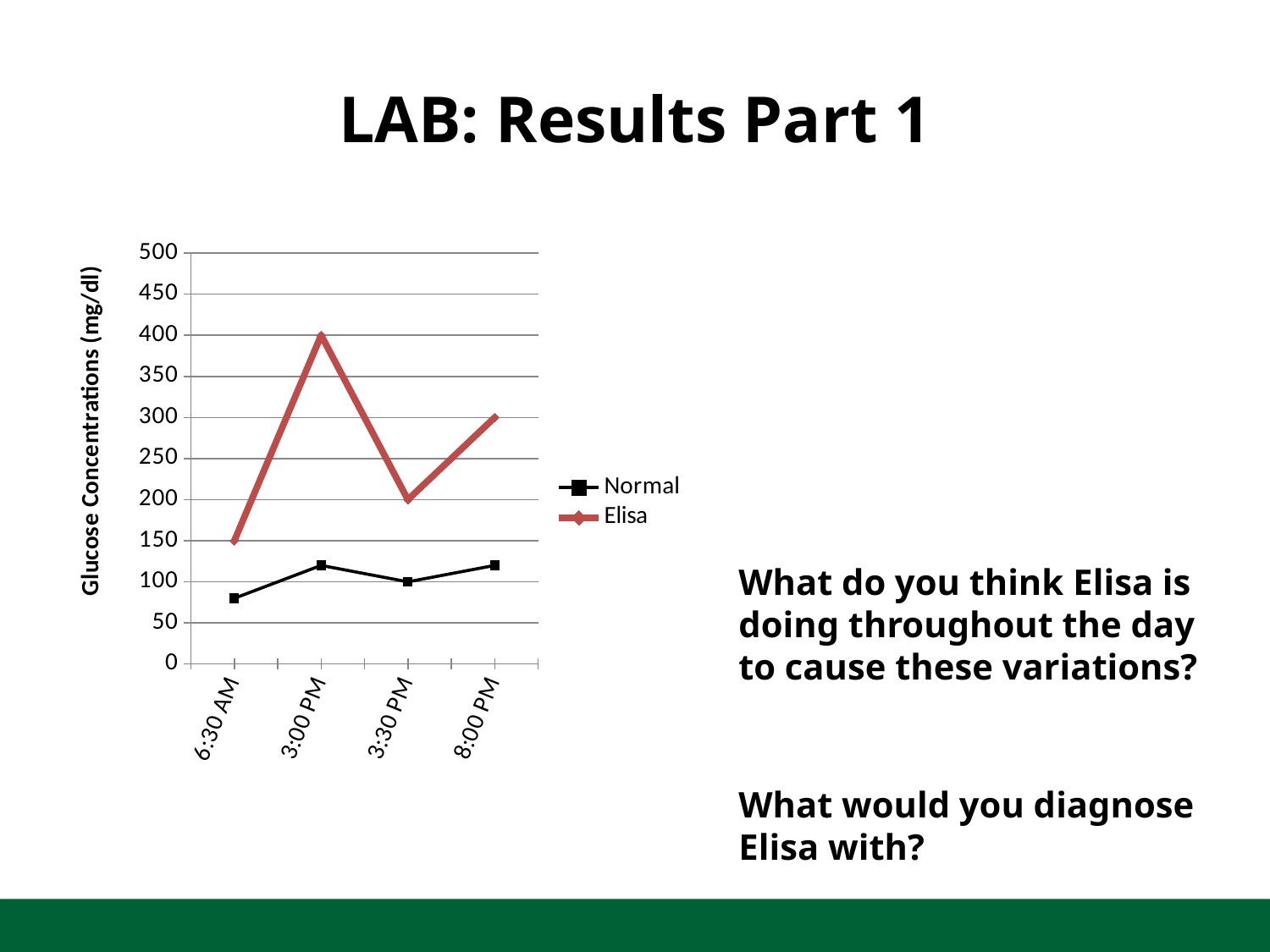
What is the label on the y axis of the chart? Glucose Concentrations (mg/dl) How many time points are plotted along the x axis? 4 What is Elisa's glucose concentration at 6:30 AM? 150 What is Elisa's glucose concentration at 3:00 PM? 400 Is the Normal value at 6:30 AM greater or less than 100? less At which time is Elisa's glucose concentration highest? 3:00 PM At 8:00 PM, which series has the higher glucose concentration, Normal or Elisa? Elisa What is the difference between Elisa's glucose concentration at 3:00 PM and at 3:30 PM? 200 How many series does the legend list? 2 At which time is Elisa's glucose concentration lowest? 6:30 AM Does Elisa's glucose concentration rise or fall from 3:00 PM to 3:30 PM? fall What kind of chart is shown on the slide? line chart